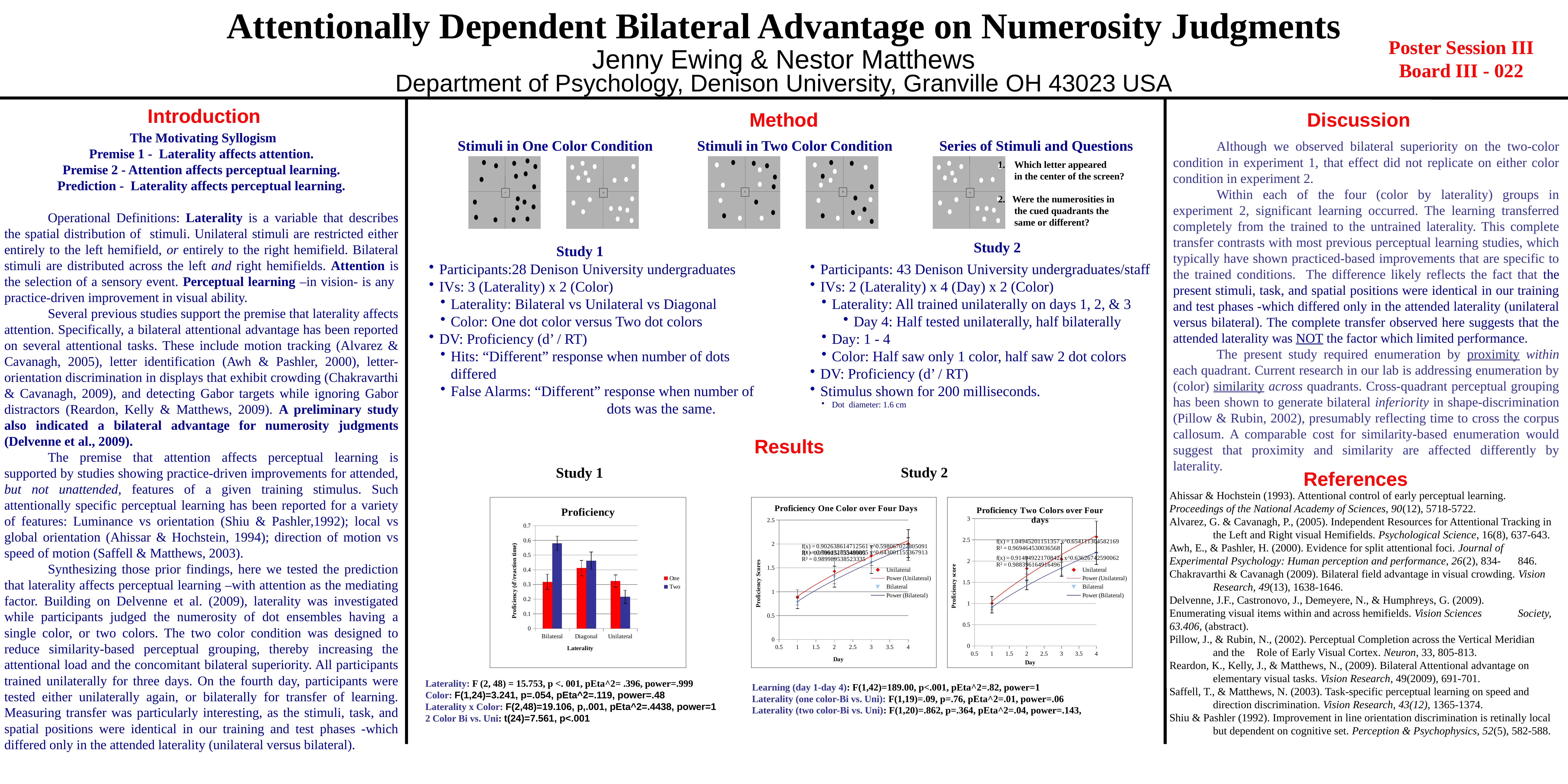
In the Study 1 'Proficiency' bar chart, for Unilateral, which series is larger, One or Two? One In the Study 1 'Proficiency' bar chart, which laterality has the lowest value for the Two series? Unilateral In the 'Proficiency One Color over Four Days' chart, do the proficiency scores rise or fall from Day 1 to Day 4? rise In the Study 1 'Proficiency' bar chart, which laterality has the highest value for the Two series? Bilateral In the Study 1 'Proficiency' bar chart, how many laterality categories are shown on the x axis? 3 In the Study 1 'Proficiency' bar chart, how many series does the legend list? 2 In the Study 1 'Proficiency' bar chart, what is the label of the y axis? Proficiency (d'/reaction time) In the Study 1 'Proficiency' bar chart, for Bilateral, which series is larger, One or Two? Two In the 'Proficiency Two Colors over Four days' chart, how many entries does the legend list? 4 In the Study 1 'Proficiency' bar chart, is the value for Bilateral in the Two series greater or less than 0.5? greater In the Study 1 'Proficiency' bar chart, is the value for Unilateral in the Two series greater or less than 0.3? less What kind of chart is the Study 1 'Proficiency' chart? bar chart